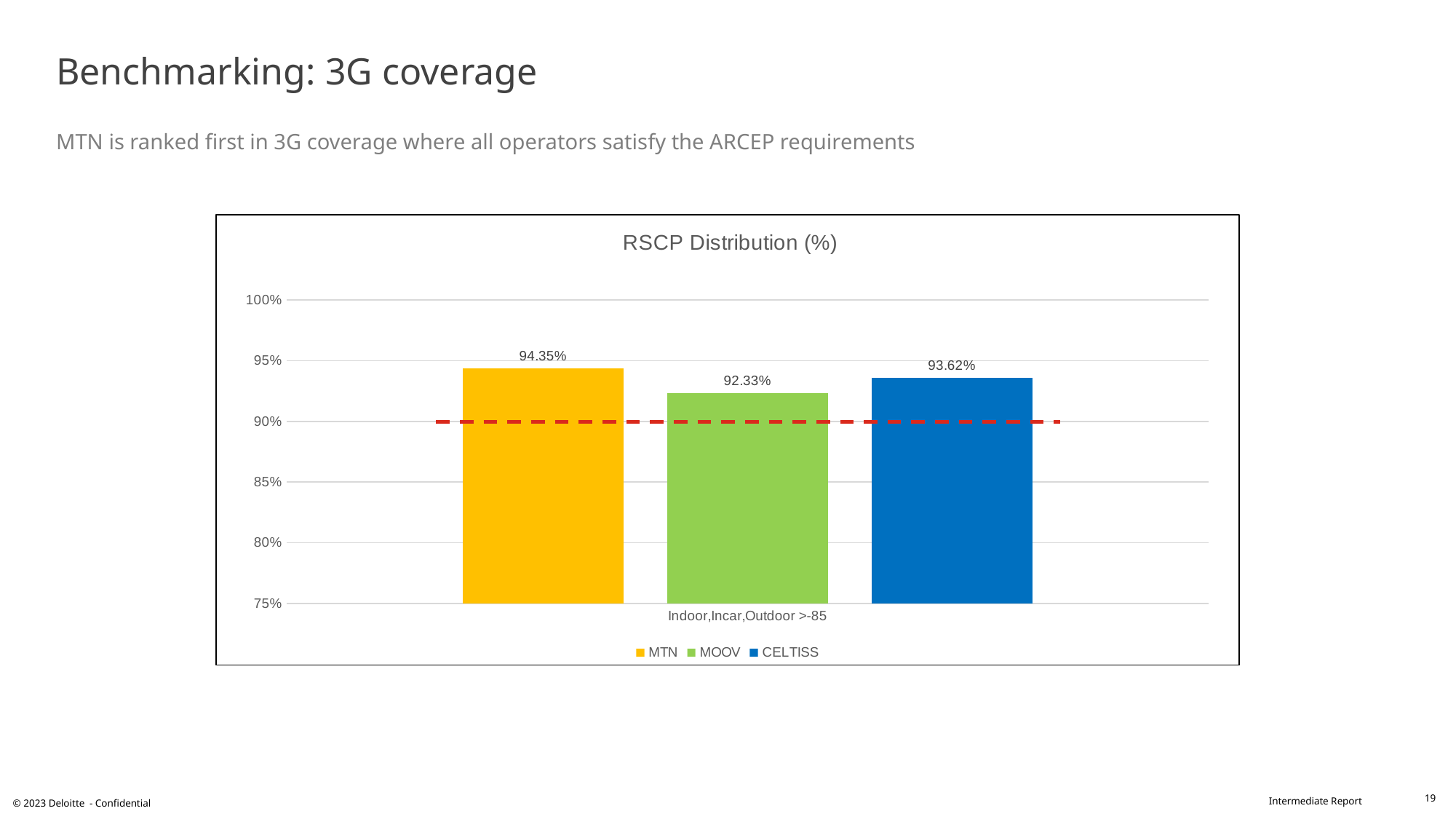
Which operator has the lowest RSCP Distribution value? MOOV What kind of chart is shown on the slide? Bar chart Is the value for MOOV greater or less than 90%? greater What is the value for CELTISS in the RSCP Distribution chart? 93.62% What is the value for MTN in the RSCP Distribution chart? 94.35% What is the title of the chart? RSCP Distribution (%) What is the difference between the CELTISS and MOOV values? 1.29% What is the value for MOOV in the RSCP Distribution chart? 92.33% How many series does the legend list? 3 Which operator has the highest RSCP Distribution value? MTN What is the difference between the MTN and MOOV values? 2.02% Which is larger, the value for CELTISS or the value for MOOV? CELTISS